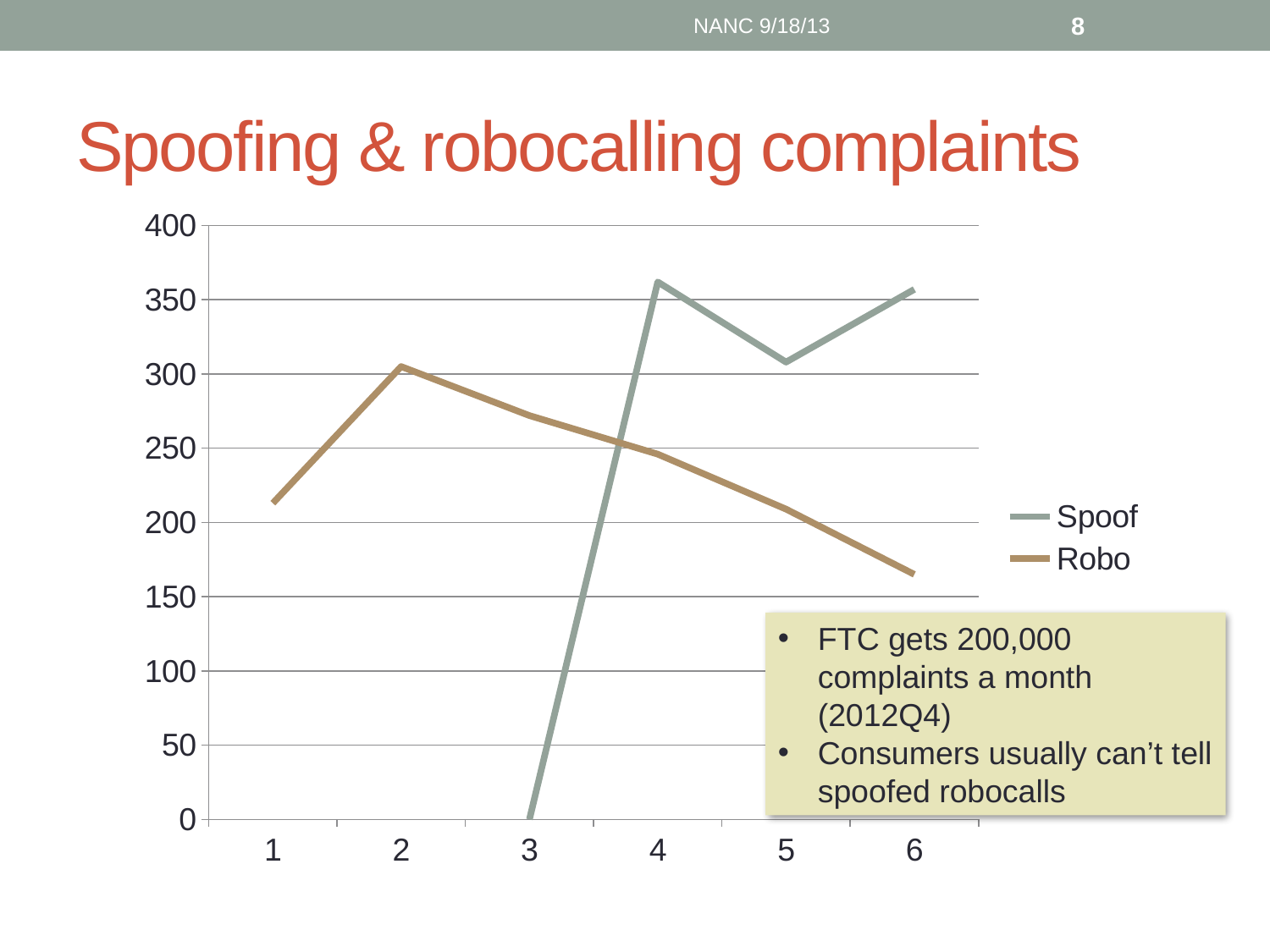
At which x-axis point does the Robo series reach its highest value? 2 At point 5, which series has the larger value, Spoof or Robo? Spoof Is the value for Spoof at point 4 greater or less than 350? greater At which x-axis point does the Robo series reach its lowest value? 6 What is the title of the slide containing the chart? Spoofing & robocalling complaints Which series are listed in the legend? Spoof and Robo Is the value for Robo at point 2 greater or less than 300? greater How many points are labelled along the x axis? 6 Does the Robo series rise or fall from point 2 to point 6? fall Is the value for Robo at point 6 greater or less than 200? less What kind of chart is shown on the slide? line chart How many series does the legend list? 2